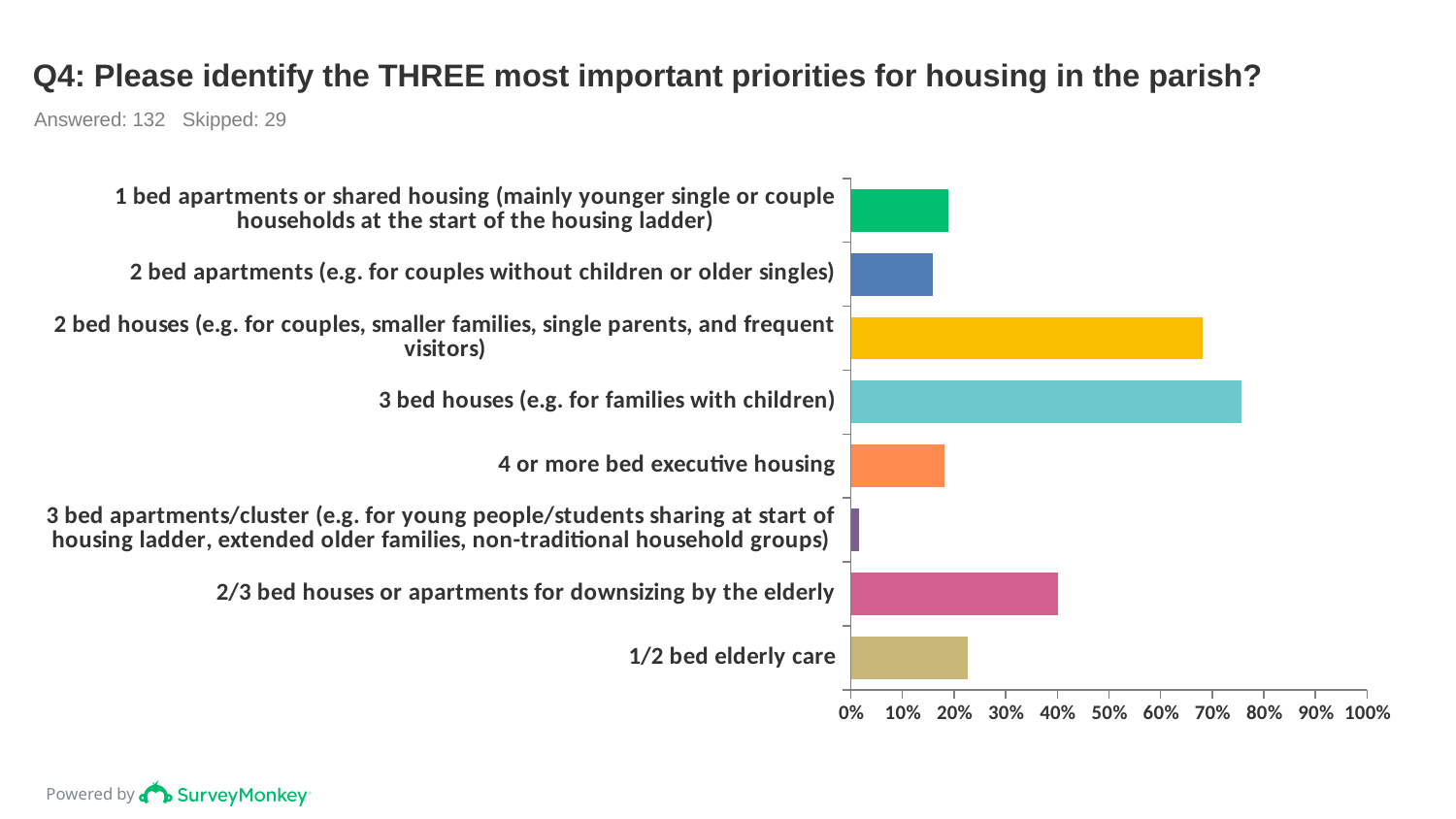
Is the value for 3 bed houses (e.g. for families with children) greater or less than 70%? greater Is the value for 2 bed houses (e.g. for couples, smaller families, single parents, and frequent visitors) greater or less than 60%? greater Is the value for 1/2 bed elderly care greater or less than 30%? less How many housing categories are plotted in the chart? 8 Which housing category has the lowest value? 3 bed apartments/cluster (e.g. for young people/students sharing at start of housing ladder, extended older families, non-traditional household groups) What kind of chart is shown on the slide? Bar chart What is the title of the chart? Q4: Please identify the THREE most important priorities for housing in the parish? Which is larger: the value for 2 bed houses or the value for 2/3 bed houses or apartments for downsizing by the elderly? 2 bed houses Which housing category has the highest value? 3 bed houses (e.g. for families with children) How many respondents answered the question according to the slide? 132